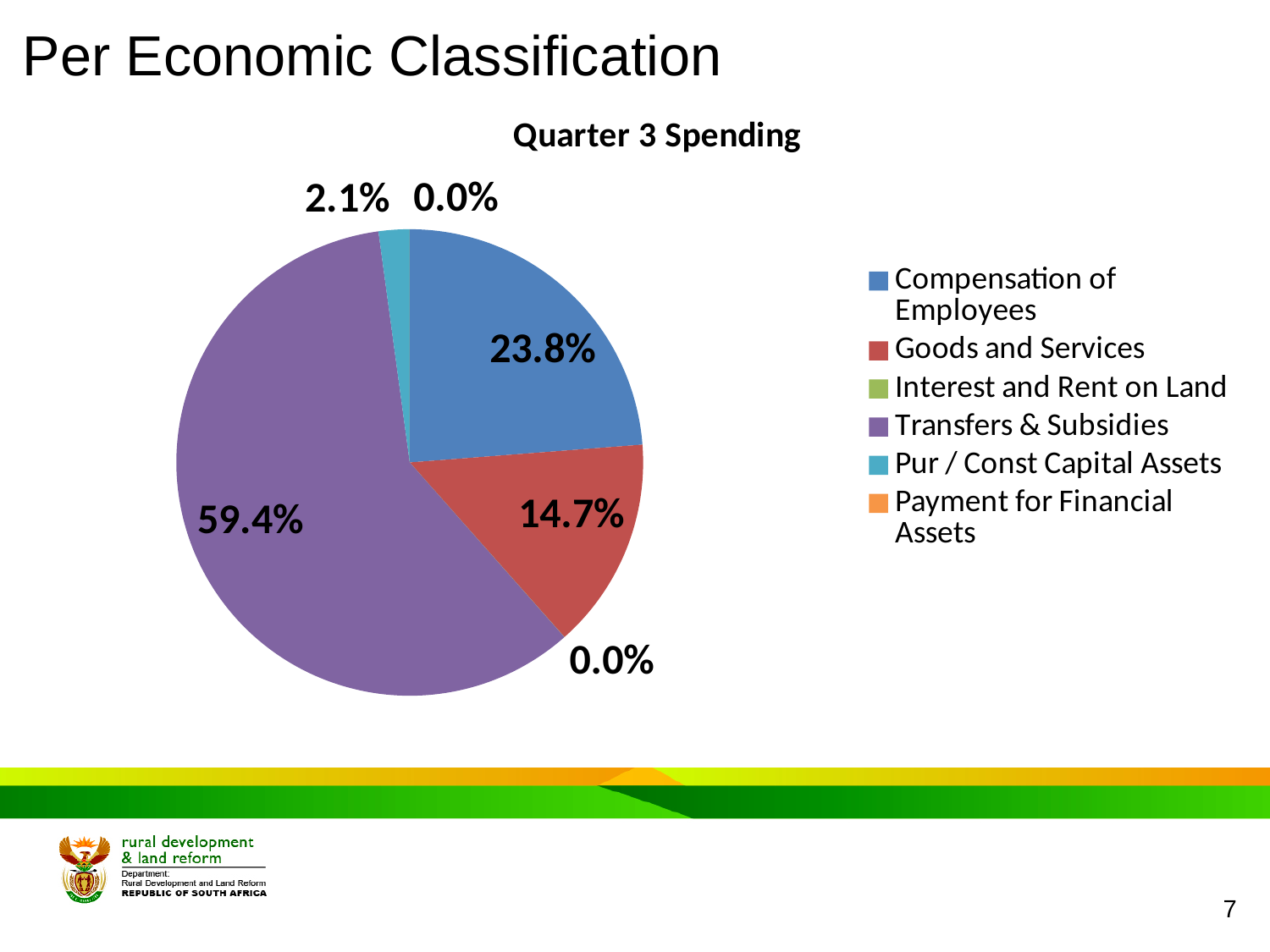
What share of Quarter 3 spending is Pur / Const Capital Assets? 2.1% Which category has the largest share of Quarter 3 spending? Transfers & Subsidies What type of chart is shown on the slide? Pie chart What colour is the Transfers & Subsidies slice? Purple What is the difference in percentage points between Transfers & Subsidies and Compensation of Employees? 35.6 What share of Quarter 3 spending is Compensation of Employees? 23.8% Which is larger, the share for Compensation of Employees or the share for Goods and Services? Compensation of Employees What is the title of the chart? Quarter 3 Spending What share of Quarter 3 spending is Goods and Services? 14.7% How many entries does the legend list? 6 What is the combined share of Compensation of Employees and Goods and Services? 38.5% What share of Quarter 3 spending is Transfers & Subsidies? 59.4%